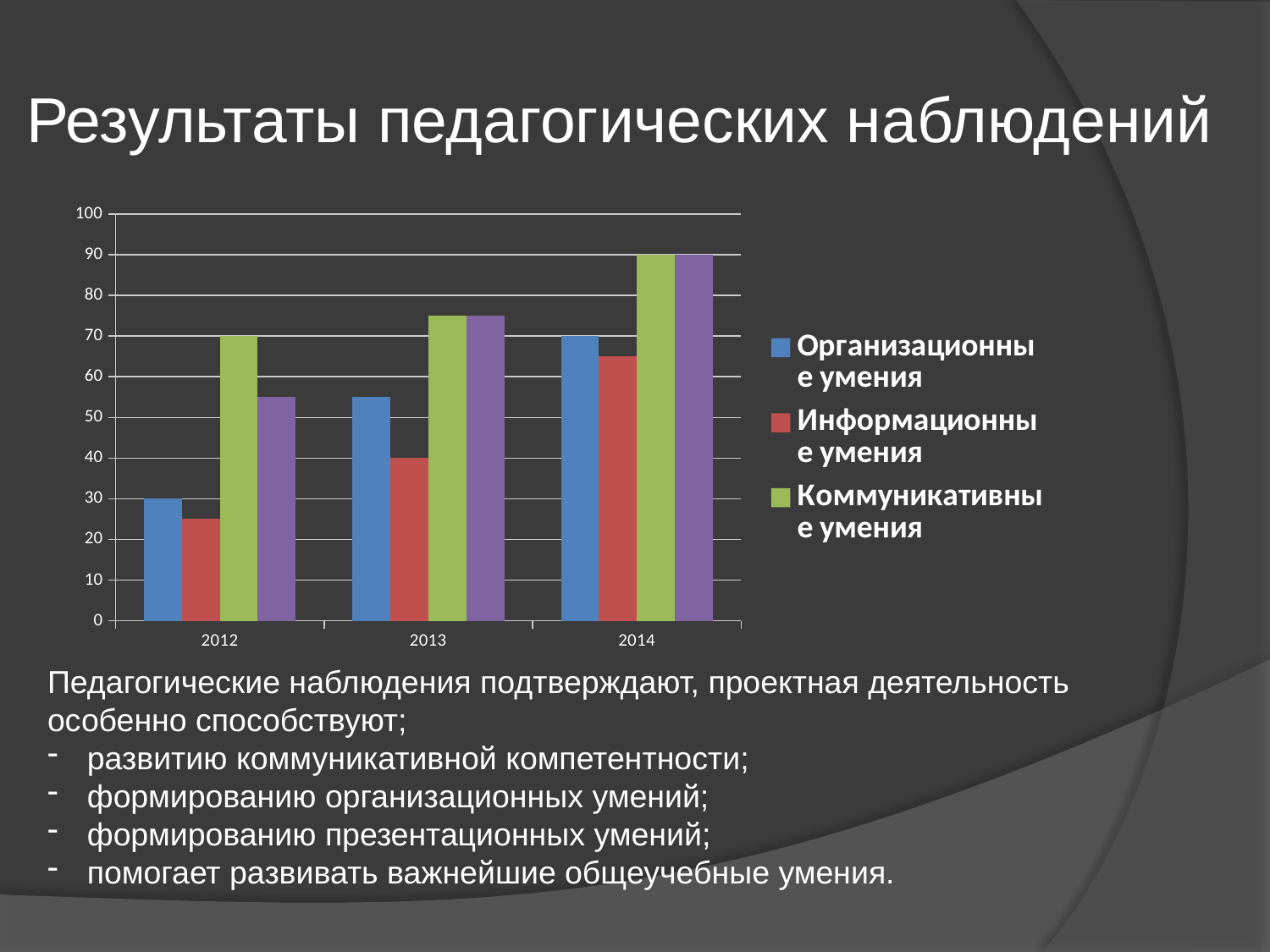
By how much did Организационные умения increase from 2012 to 2014? 40 Is the value for Информационные умения in 2012 greater or less than 30? less What is the value for Организационные умения in 2012? 30 What is the value for Коммуникативные умения in 2012? 70 In which year is Коммуникативные умения highest? 2014 What kind of chart is shown on the slide? bar chart Is the value for Организационные умения in 2013 greater or less than 50? greater Which is larger in 2012: Коммуникативные умения or Организационные умения? Коммуникативные умения How many entries does the chart's legend list? 3 How many years are shown on the x axis of the chart? 3 What is the value for Коммуникативные умения in 2014? 90 What is the value for Информационные умения in 2013? 40